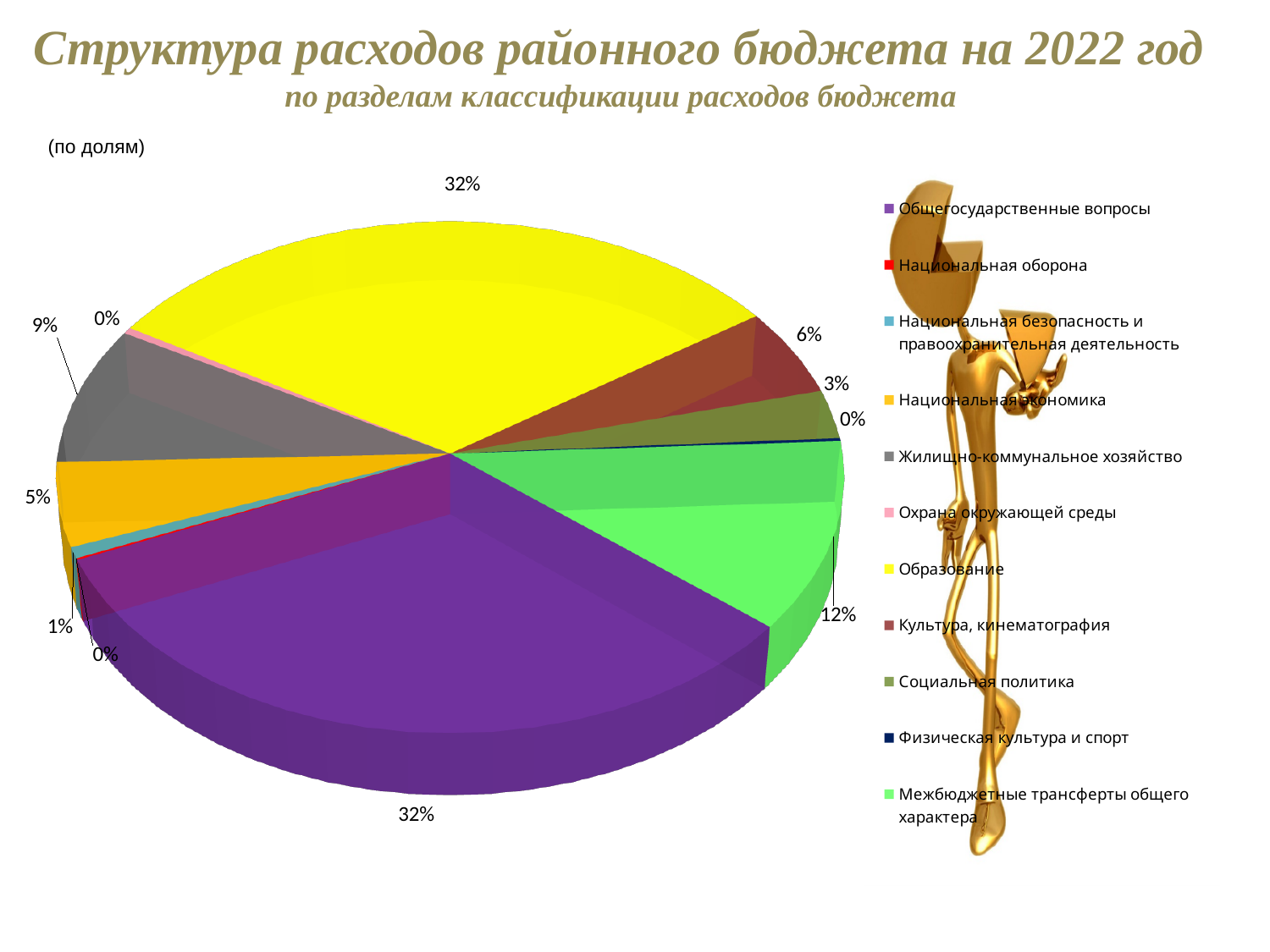
How many categories does the legend list? 11 What is the difference in percentage points between the share for Культура, кинематография and the share for Социальная политика? 3 Which is larger, the share for Образование or the share for Межбюджетные трансферты общего характера? Образование What share of the pie does Жилищно-коммунальное хозяйство have? 9% What is the title of the chart on the slide? Структура расходов районного бюджета на 2022 год What share of the pie does Национальная экономика have? 5% What share of the pie does Образование have? 32% What share of the pie does Культура, кинематография have? 6% What kind of chart is shown on the slide? pie chart What share of the pie does Общегосударственные вопросы have? 32% What share of the pie does Социальная политика have? 3% What share of the pie does Межбюджетные трансферты общего характера have? 12%